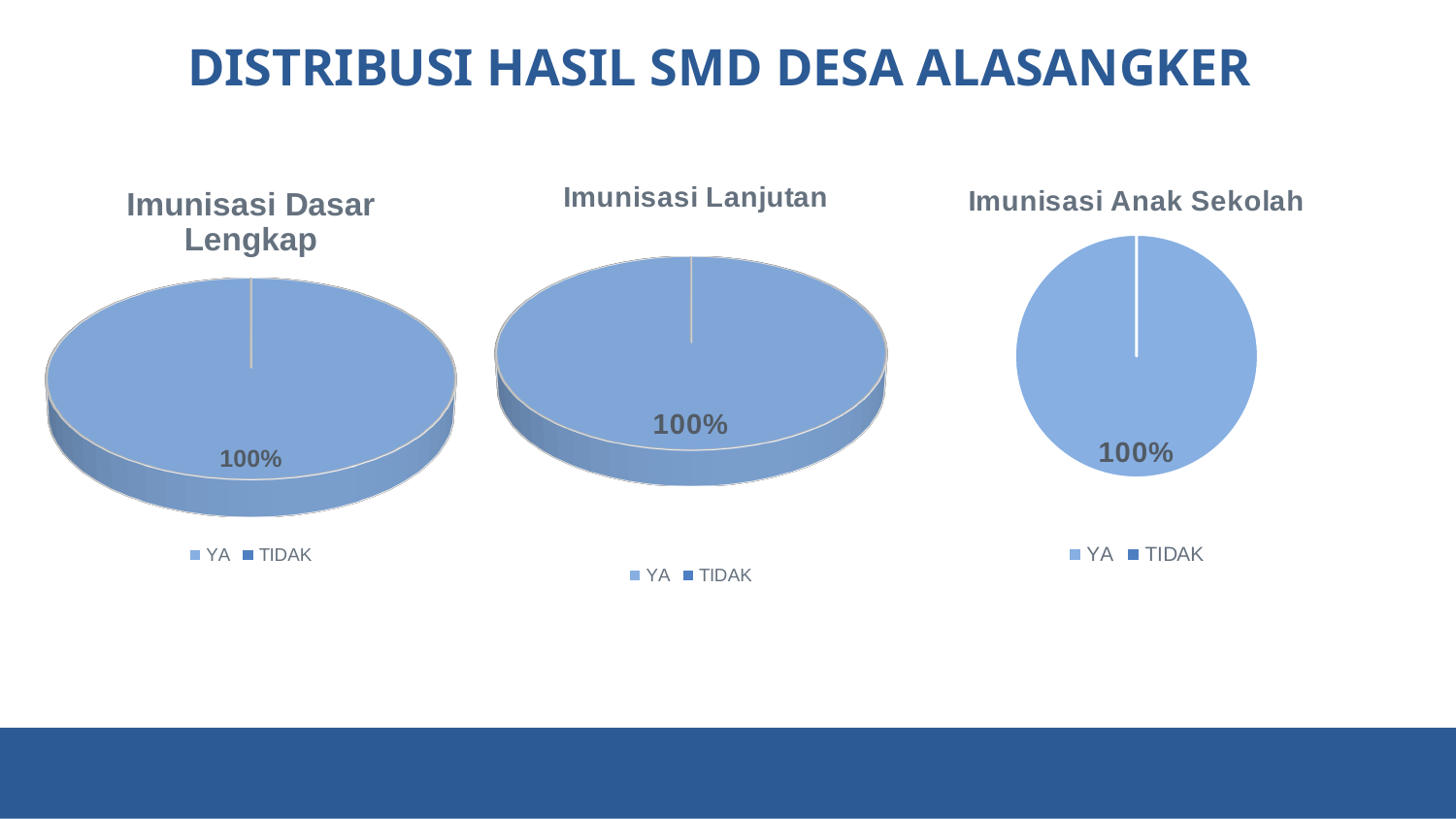
In the "Imunisasi Lanjutan" chart, what percentage is printed on the pie? 100% How many entries does the legend of the "Imunisasi Lanjutan" chart list? 2 In the "Imunisasi Anak Sekolah" chart, what share of the pie does YA take? 100% What kind of chart is the "Imunisasi Dasar Lengkap" chart? Pie chart In the "Imunisasi Dasar Lengkap" chart, which category has the largest share? YA In the "Imunisasi Anak Sekolah" chart, which category has the largest share? YA What kind of chart is the "Imunisasi Anak Sekolah" chart? Pie chart How many pie charts are shown on the slide? 3 What are the two legend entries in the "Imunisasi Anak Sekolah" chart? YA and TIDAK In the "Imunisasi Dasar Lengkap" chart, what share is shown for YA? 100% What is the title of the chart on the right of the slide? Imunisasi Anak Sekolah